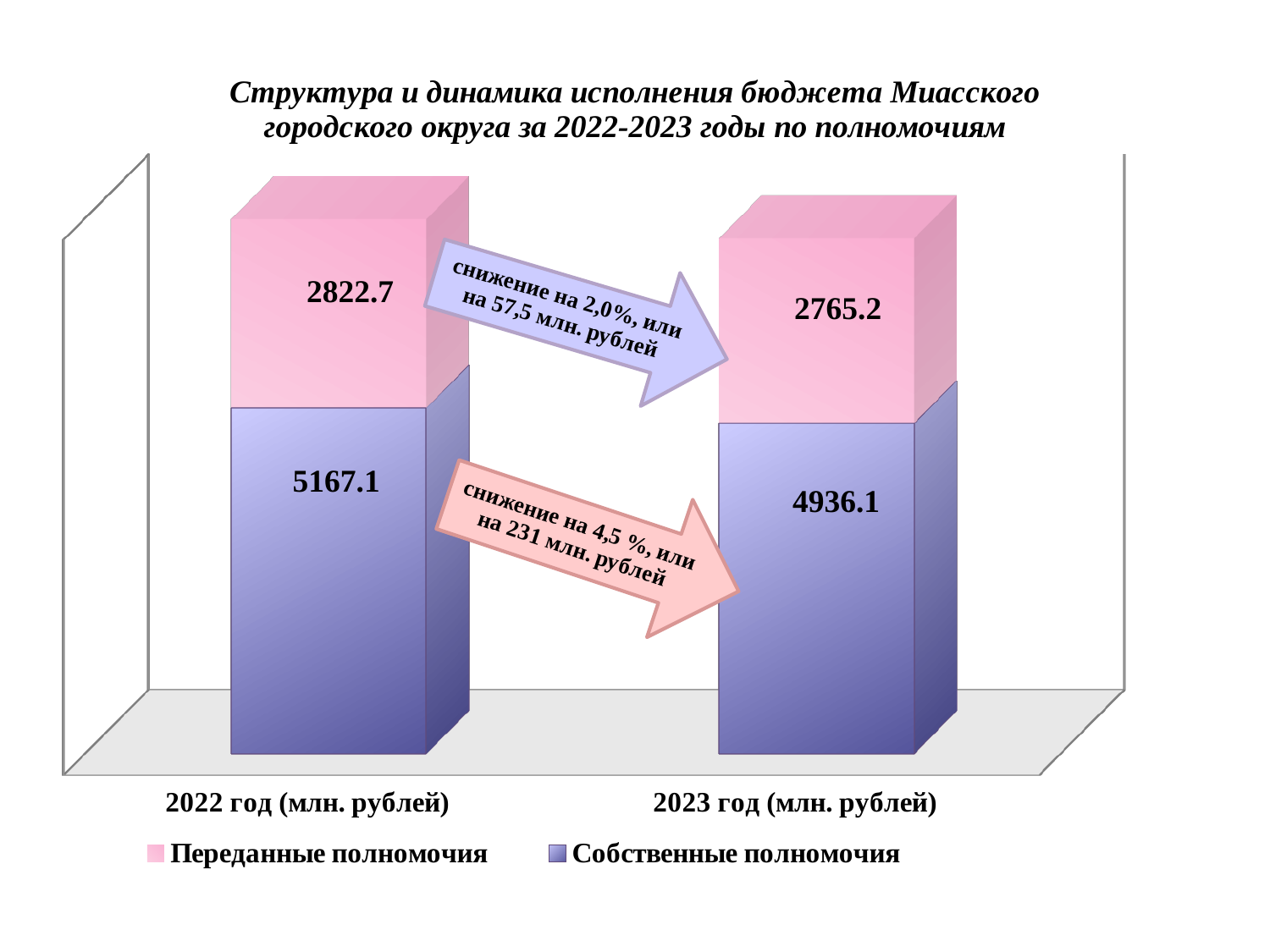
What kind of chart is shown on the slide? Stacked bar chart Which is larger in 2023: Переданные полномочия or Собственные полномочия? Собственные полномочия What is the value of Переданные полномочия for 2023 год (млн. рублей)? 2765.2 What is the value of Собственные полномочия for 2022 год (млн. рублей)? 5167.1 What is the difference between Переданные полномочия in 2022 and in 2023? 57.5 Do the values of Собственные полномочия rise or fall from 2022 to 2023? Fall What is the value of Собственные полномочия for 2023 год (млн. рублей)? 4936.1 How many series does the legend list? 2 What is the total of the stacked bar for 2023 год (млн. рублей)? 7701.3 What is the total of the stacked bar for 2022 год (млн. рублей)? 7989.8 What is the value of Переданные полномочия for 2022 год (млн. рублей)? 2822.7 By how much did Собственные полномочия decrease from 2022 to 2023? 231